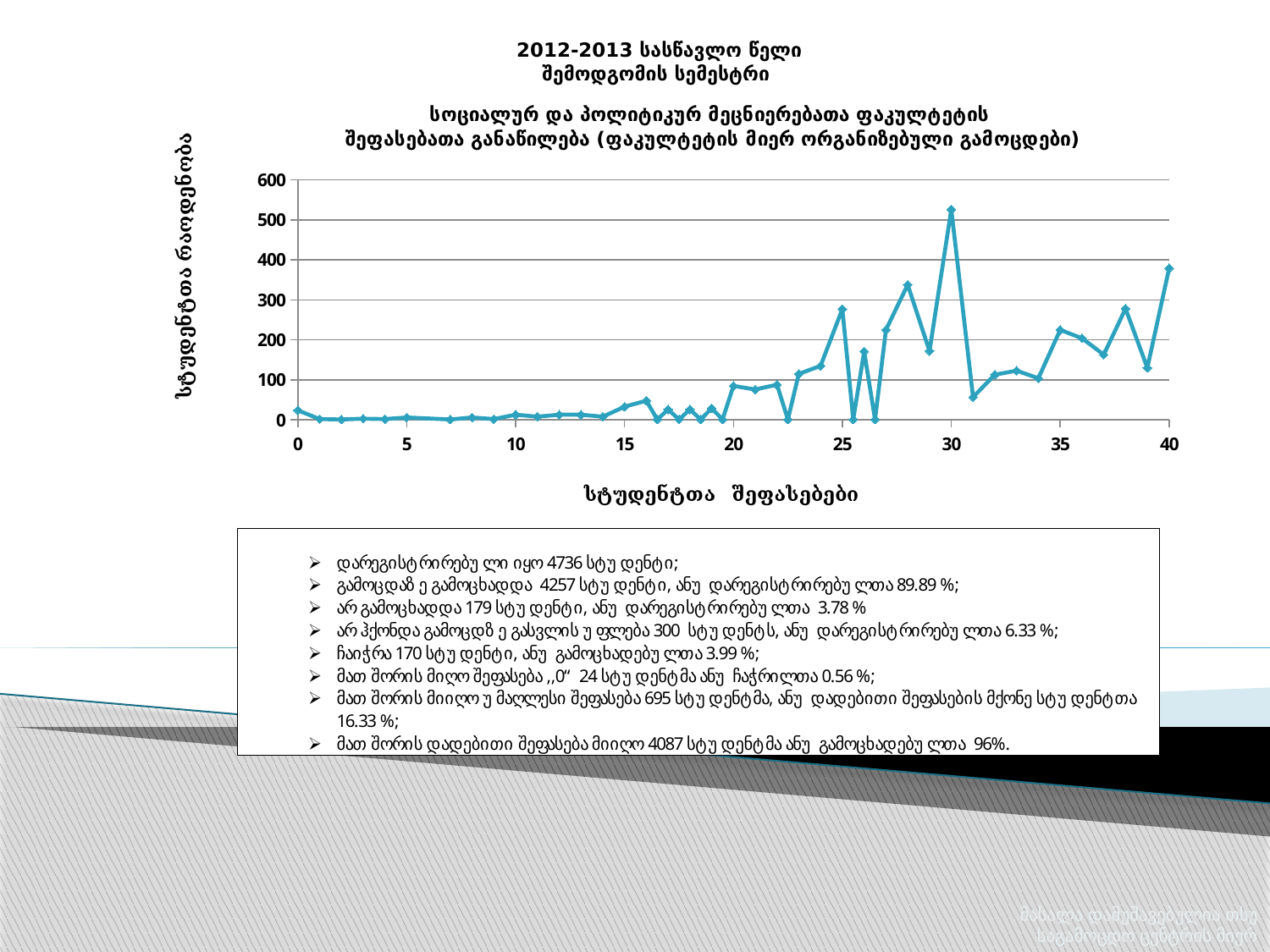
What is the title of the x-axis? სტუდენტთა შეფასებები Is the value at x = 40 greater or less than 400? less Overall, do the values rise or fall as the x-axis goes from 0 to 40? rise At which x-axis value does the line reach its highest point? 30 Is the value at x = 35 greater or less than 200? greater Is the value at x = 25 greater or less than 300? less What is the highest value labelled on the y-axis? 600 What kind of chart is shown on the slide? line chart Which has the larger value, x = 30 or x = 40? x = 30